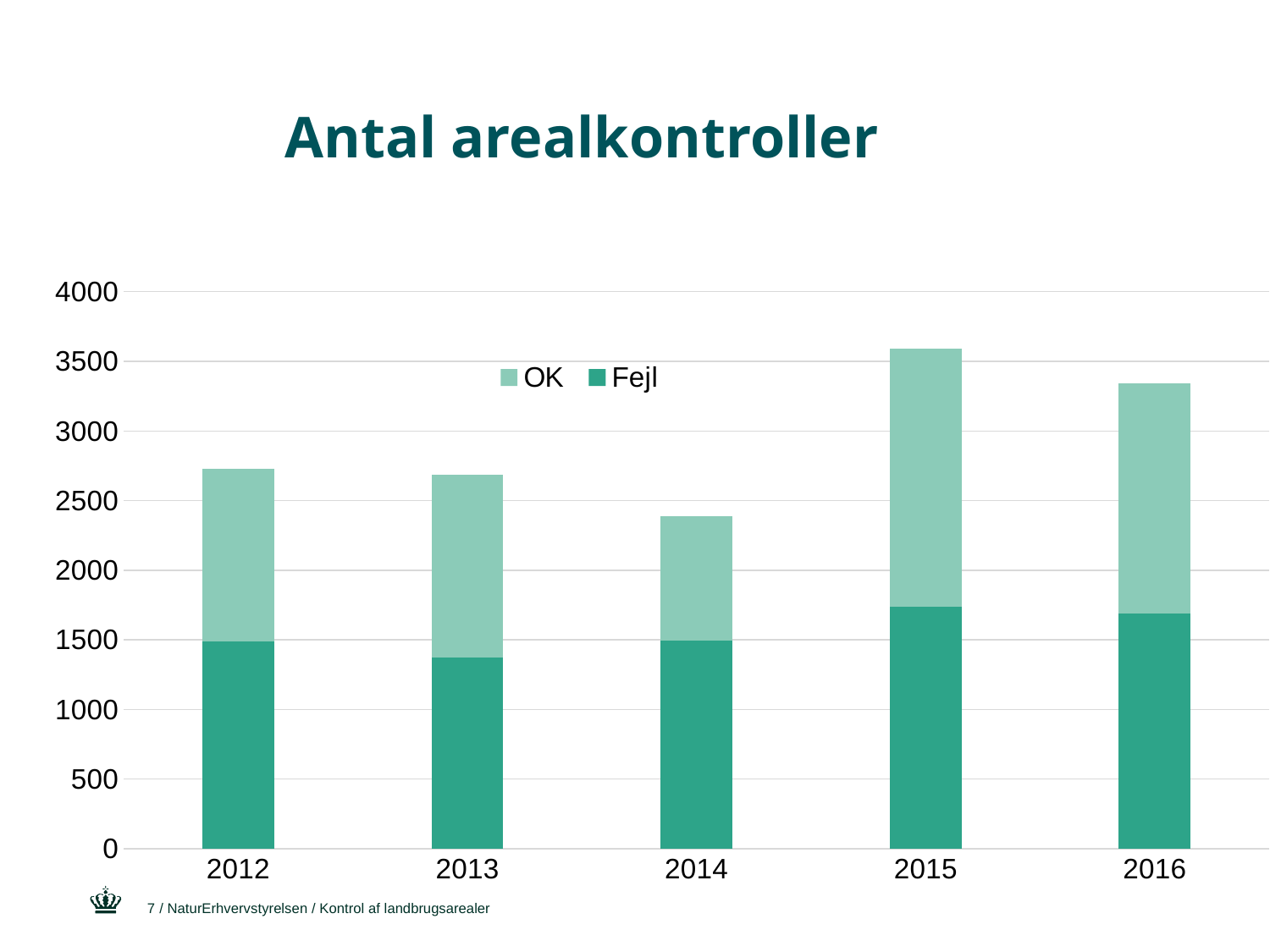
What is the title of the chart? Antal arealkontroller How many years are shown on the x axis? 5 Is the Fejl value for 2015 greater or less than 1500? greater Is the total for 2014 greater or less than 2500? less Which year has the larger total, 2015 or 2016? 2015 Which year has the lowest Fejl value? 2013 How many series does the legend list? 2 What kind of chart is shown on the slide? stacked bar chart Which series are listed in the legend? OK and Fejl Which year has the lowest total number of arealkontroller? 2014 Which year has the highest total number of arealkontroller? 2015 Is the total for 2015 greater or less than 3500? greater